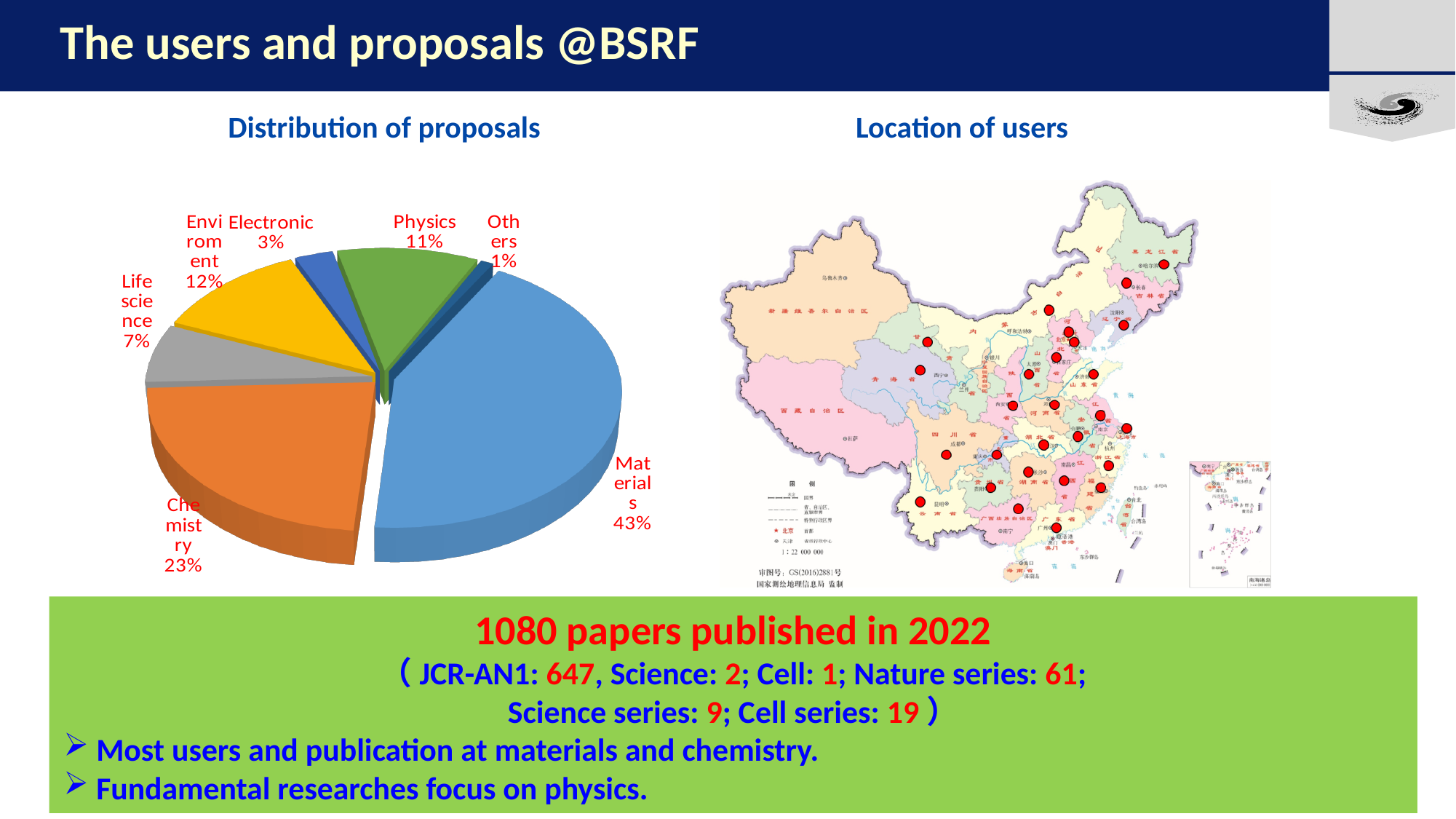
What is the title of the pie chart on the left of the slide? Distribution of proposals What type of chart is used to show the distribution of proposals? Pie chart In the Distribution of proposals chart, what share of proposals is for Life science? 7% In the Distribution of proposals chart, which category has the largest share? Materials In the Distribution of proposals chart, what share of proposals is for Materials? 43% In the Distribution of proposals chart, how many percentage points larger is the Materials share than the Chemistry share? 20 How many categories are shown in the Distribution of proposals pie chart? 7 In the Distribution of proposals chart, what share of proposals is for Physics? 11% In the Distribution of proposals chart, which has a larger share, Environment or Physics? Environment In the Distribution of proposals chart, what share of proposals is for Chemistry? 23% In the Distribution of proposals chart, which category has the smallest share? Others In the Distribution of proposals chart, what share of proposals is for Environment? 12%